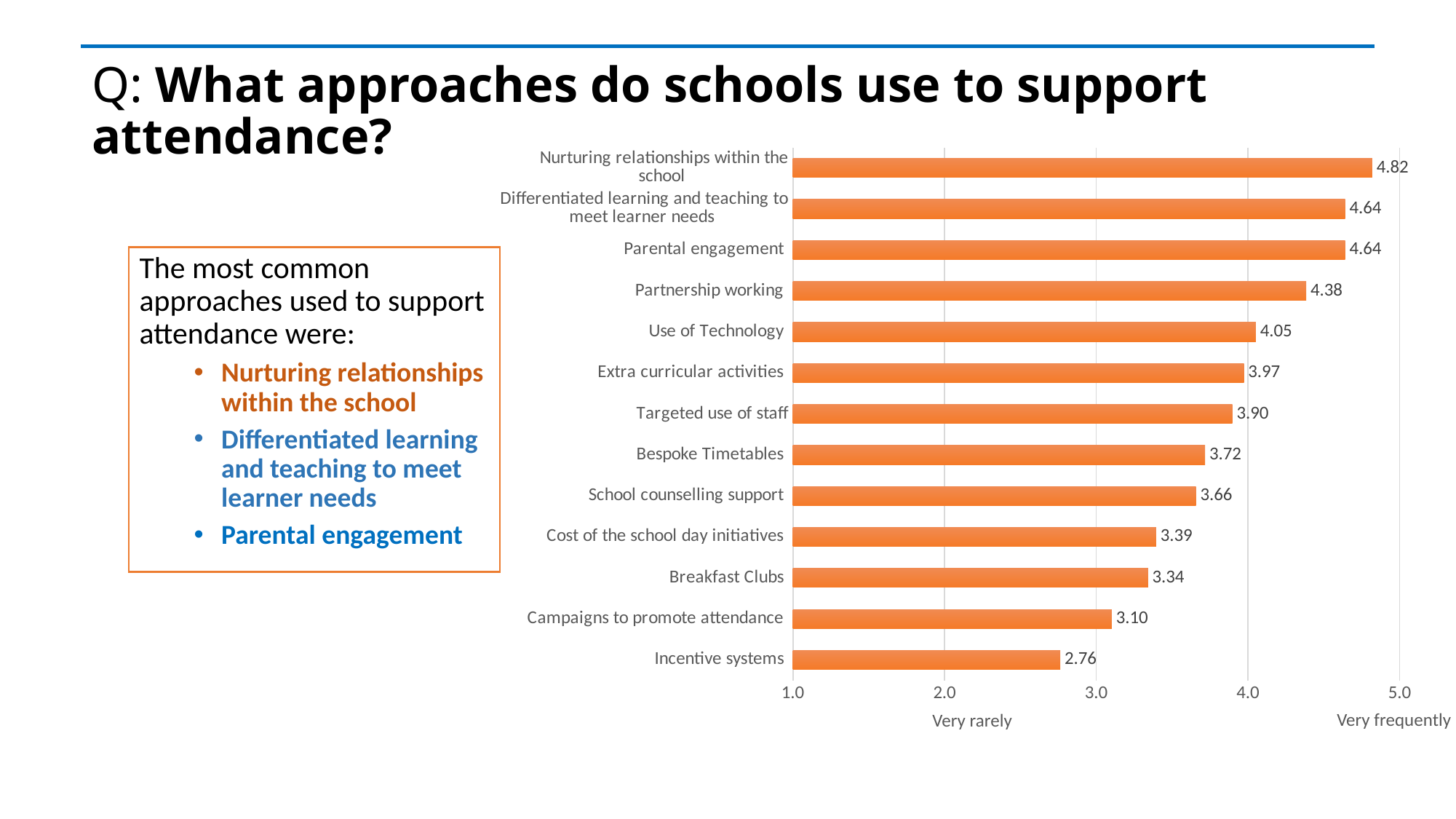
What is the value for Partnership working? 4.38 What is the value for School counselling support? 3.66 How many categories are shown in the chart? 13 What label appears at the right end of the x axis? Very frequently What is the difference between the values for Use of Technology and Extra curricular activities? 0.08 Which category has the highest value? Nurturing relationships within the school What kind of chart is shown on the slide? bar chart Which category has the lowest value? Incentive systems Which is larger, the value for Bespoke Timetables or the value for Cost of the school day initiatives? Bespoke Timetables Is the value for Campaigns to promote attendance greater or less than 4.0? less What is the value for Breakfast Clubs? 3.34 What is the difference between the values for Nurturing relationships within the school and Incentive systems? 2.06